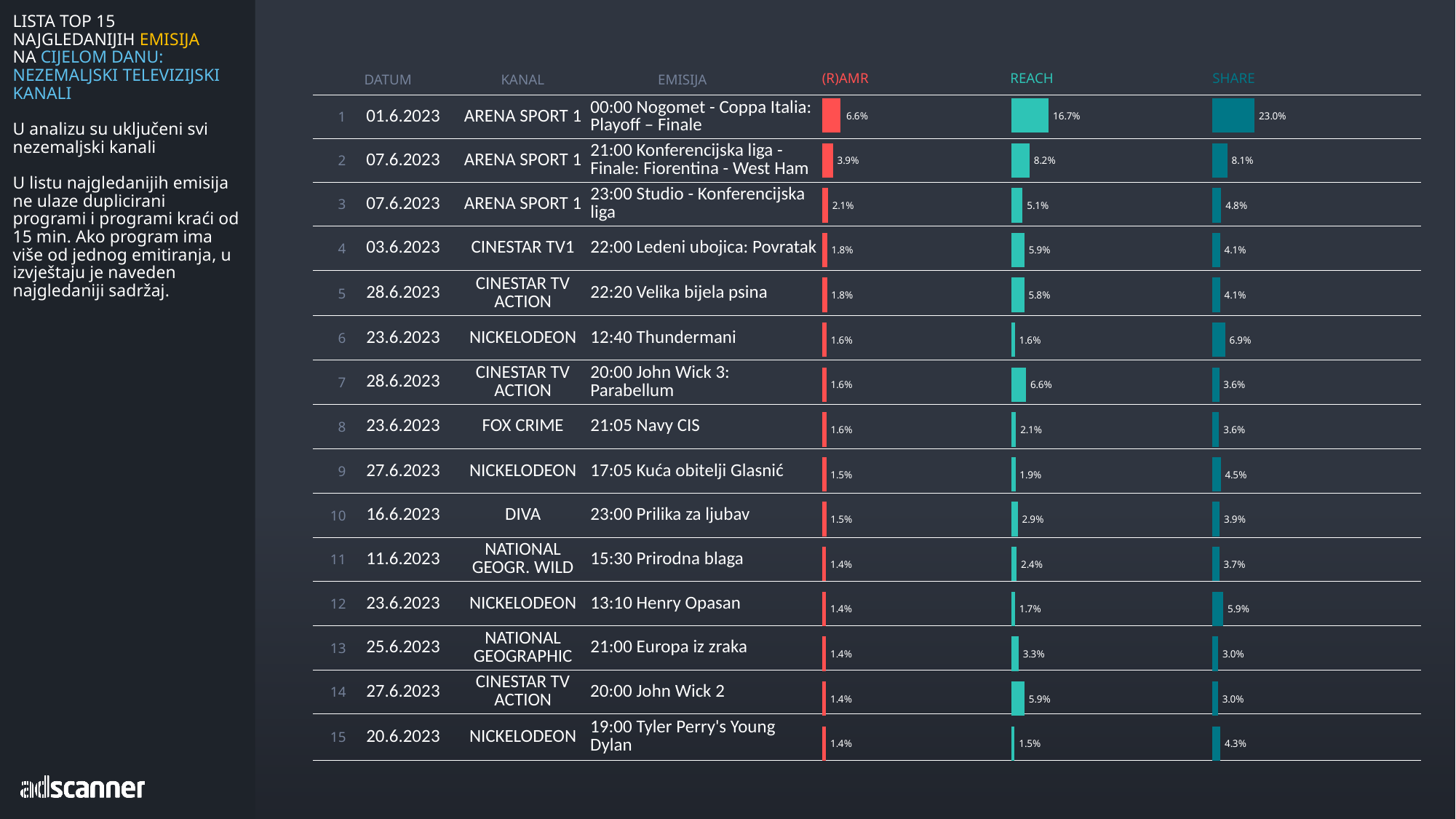
What kind of chart is used for the REACH column? Bar chart In the SHARE chart, what is the difference between 00:00 Nogomet - Coppa Italia: Playoff – Finale and 21:00 Konferencijska liga - Finale: Fiorentina - West Ham? 14.9% In the REACH chart, which programme has the highest value? 00:00 Nogomet - Coppa Italia: Playoff – Finale In the (R)AMR chart, what is the difference between 21:00 Konferencijska liga - Finale: Fiorentina - West Ham and 23:00 Studio - Konferencijska liga? 1.8% In the REACH chart, what is the value for 20:00 John Wick 3: Parabellum? 6.6% In the SHARE chart, which programme has the highest value? 00:00 Nogomet - Coppa Italia: Playoff – Finale Do the (R)AMR values rise or fall going down the list from rank 1 to rank 15? Fall In the REACH chart, which is larger: 22:00 Ledeni ubojica: Povratak or 21:05 Navy CIS? 22:00 Ledeni ubojica: Povratak How many programmes are listed in the (R)AMR chart? 15 In the REACH chart, which programme has the lowest value? 19:00 Tyler Perry's Young Dylan In the SHARE chart, what is the value for 12:40 Thundermani? 6.9% In the (R)AMR chart, what is the value for 00:00 Nogomet - Coppa Italia: Playoff – Finale? 6.6%